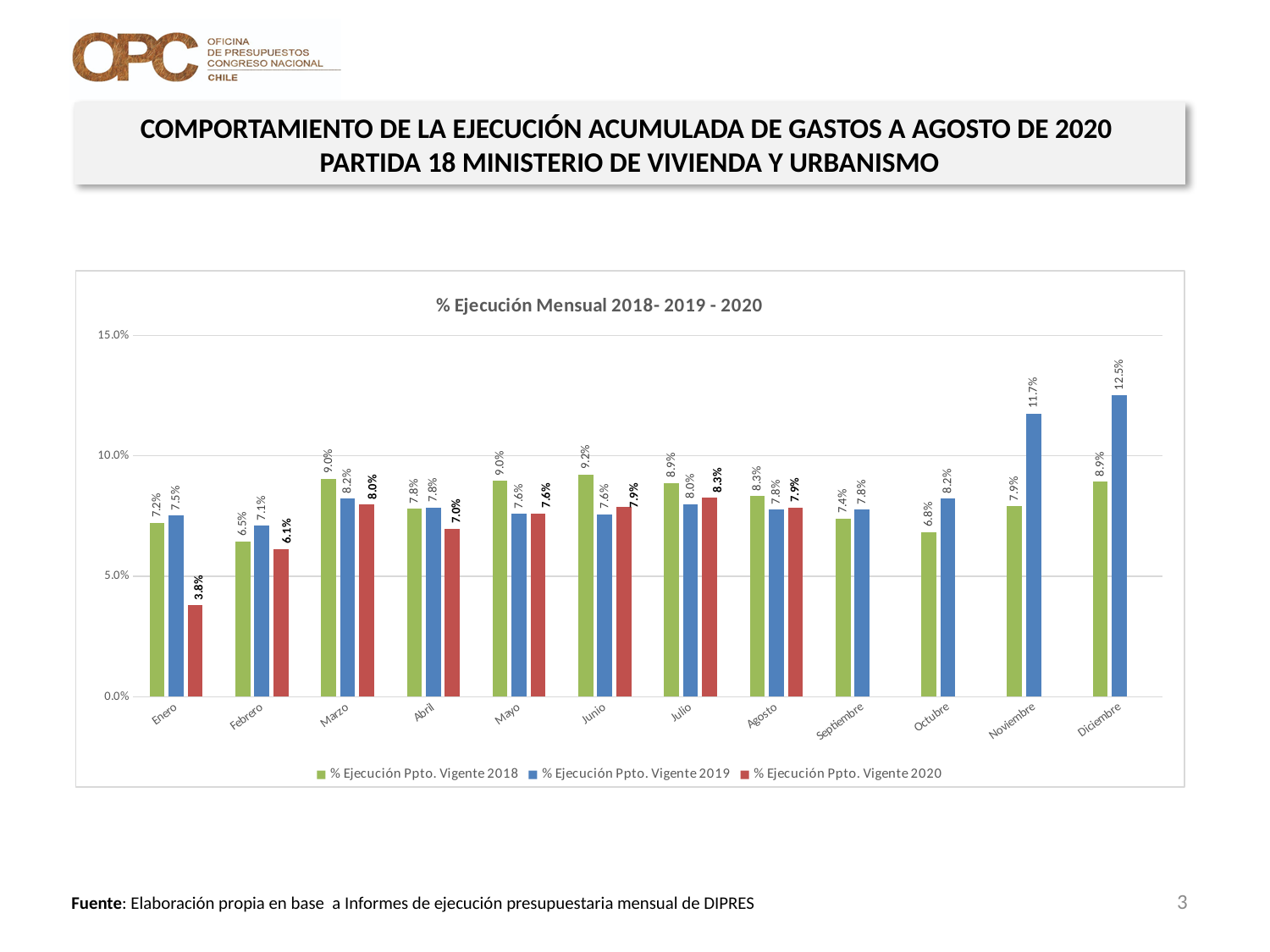
What is the value for % Ejecución Ppto. Vigente 2020 in Enero? 3.8% In Marzo, which series has the larger value: % Ejecución Ppto. Vigente 2018 or % Ejecución Ppto. Vigente 2019? % Ejecución Ppto. Vigente 2018 How many series does the legend list? 3 What is the difference between the 2019 and 2018 values in Noviembre? 3.8% Is the value for % Ejecución Ppto. Vigente 2019 in Noviembre greater or less than 10.0%? greater Which month has the highest value for % Ejecución Ppto. Vigente 2019? Diciembre What kind of chart is shown on the slide? Bar chart What is the title of the chart? % Ejecución Mensual 2018- 2019 - 2020 How many months are shown on the x axis? 12 Which month has the lowest value for % Ejecución Ppto. Vigente 2020? Enero What is the value for % Ejecución Ppto. Vigente 2019 in Diciembre? 12.5% What is the value for % Ejecución Ppto. Vigente 2018 in Junio? 9.2%